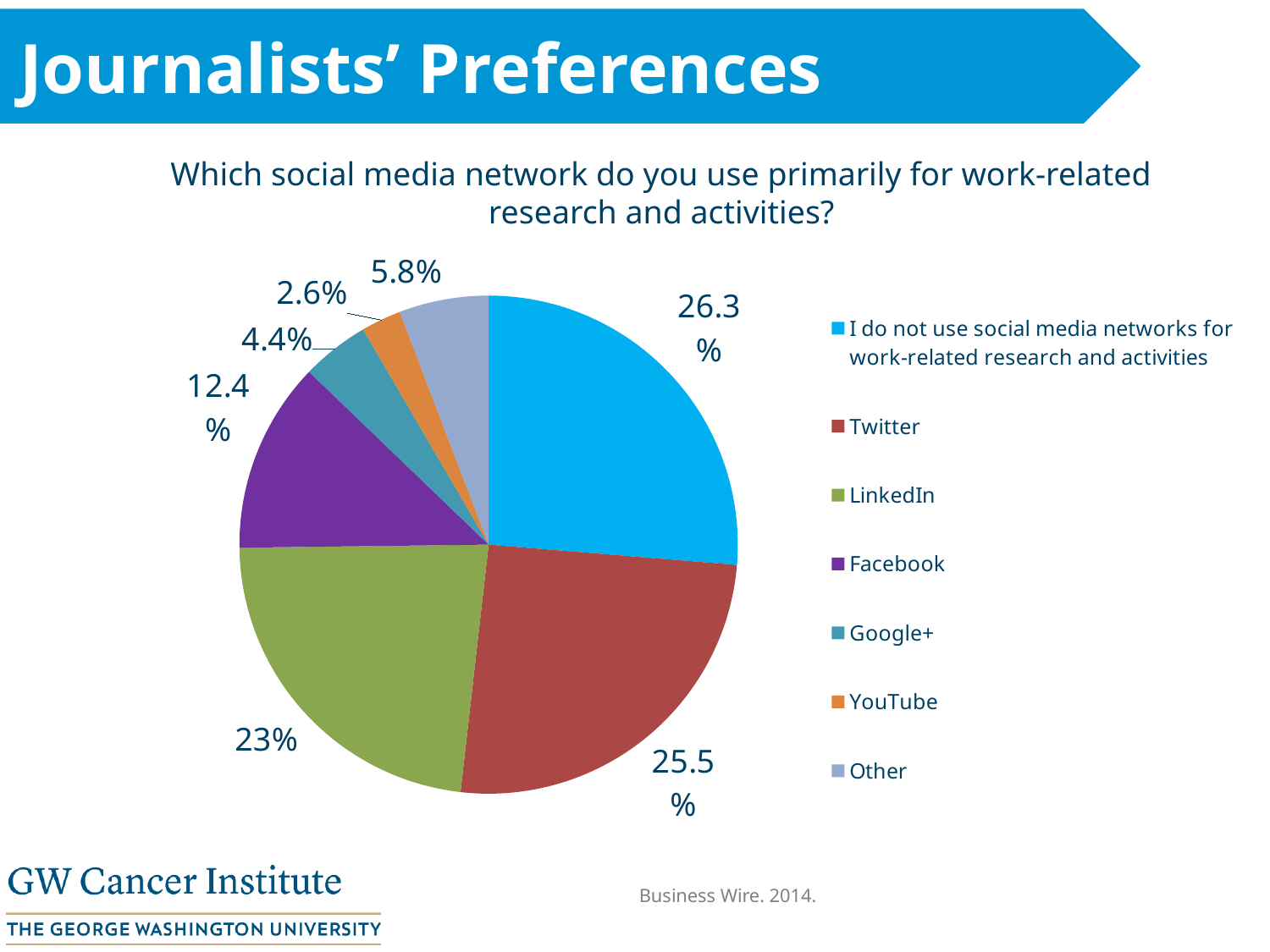
Which is larger, the share for Facebook or the share for Google+? Facebook What kind of chart is shown on the slide? Pie chart Which category has the largest slice of the pie? I do not use social media networks for work-related research and activities How many categories does the legend list? 7 What percentage of journalists use Facebook primarily for work-related research and activities? 12.4% What is the difference in percentage points between Twitter and LinkedIn? 2.5 What percentage of journalists use LinkedIn primarily for work-related research and activities? 23% What is the source cited for the chart? Business Wire. 2014. What percentage of journalists use Twitter primarily for work-related research and activities? 25.5% Which category has the smallest slice of the pie? YouTube What percentage of journalists do not use social media networks for work-related research and activities? 26.3% What percentage of journalists use YouTube primarily for work-related research and activities? 2.6%